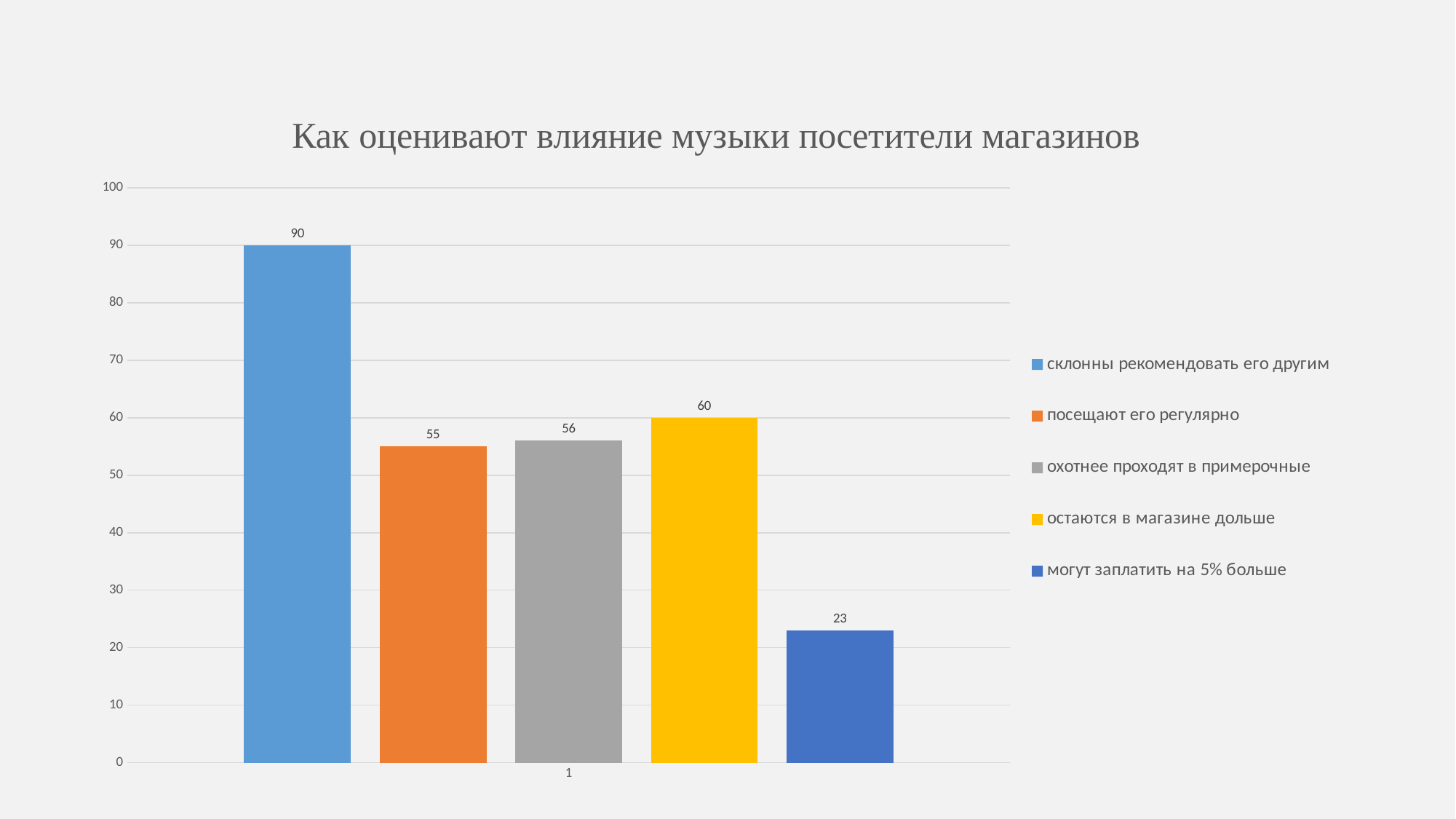
What is the value for "охотнее проходят в примерочные"? 56 Which series has the lowest value? могут заплатить на 5% больше What is the value for "могут заплатить на 5% больше"? 23 How many series does the legend list? 5 What is the value for "склонны рекомендовать его другим"? 90 What is the difference between the values for "склонны рекомендовать его другим" and "могут заплатить на 5% больше"? 67 Which series has the highest value? склонны рекомендовать его другим Which is larger: the value for "остаются в магазине дольше" or the value for "посещают его регулярно"? остаются в магазине дольше What is the title of the chart? Как оценивают влияние музыки посетители магазинов What is the value for "посещают его регулярно"? 55 What is the value for "остаются в магазине дольше"? 60 What kind of chart is shown on the slide? Bar chart